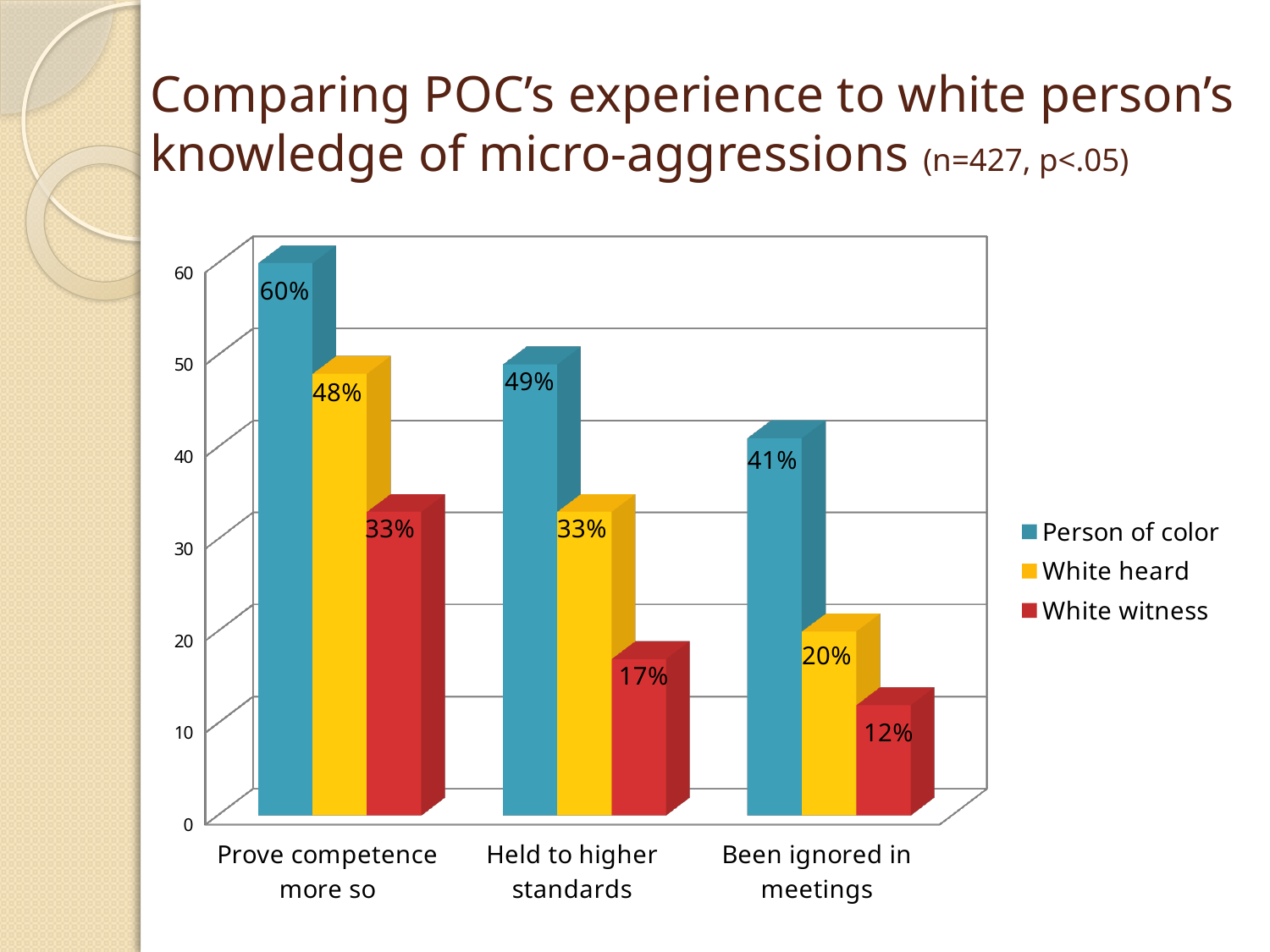
What is the value for White witness in the Been ignored in meetings category? 12% What colour represents the White witness series? Red What is the difference between the Person of color and White witness values in the Held to higher standards category? 32% How many categories are shown on the x axis? 3 Which category has the lowest value for White heard? Been ignored in meetings What kind of chart is shown on the slide? Bar chart What is the value for White heard in the Held to higher standards category? 33% Do the Person of color values rise or fall across the categories from left to right? Fall Which is larger in the Been ignored in meetings category: White heard or White witness? White heard How many series does the legend list? 3 What is the value for Person of color in the Prove competence more so category? 60% Which category has the highest value for Person of color? Prove competence more so